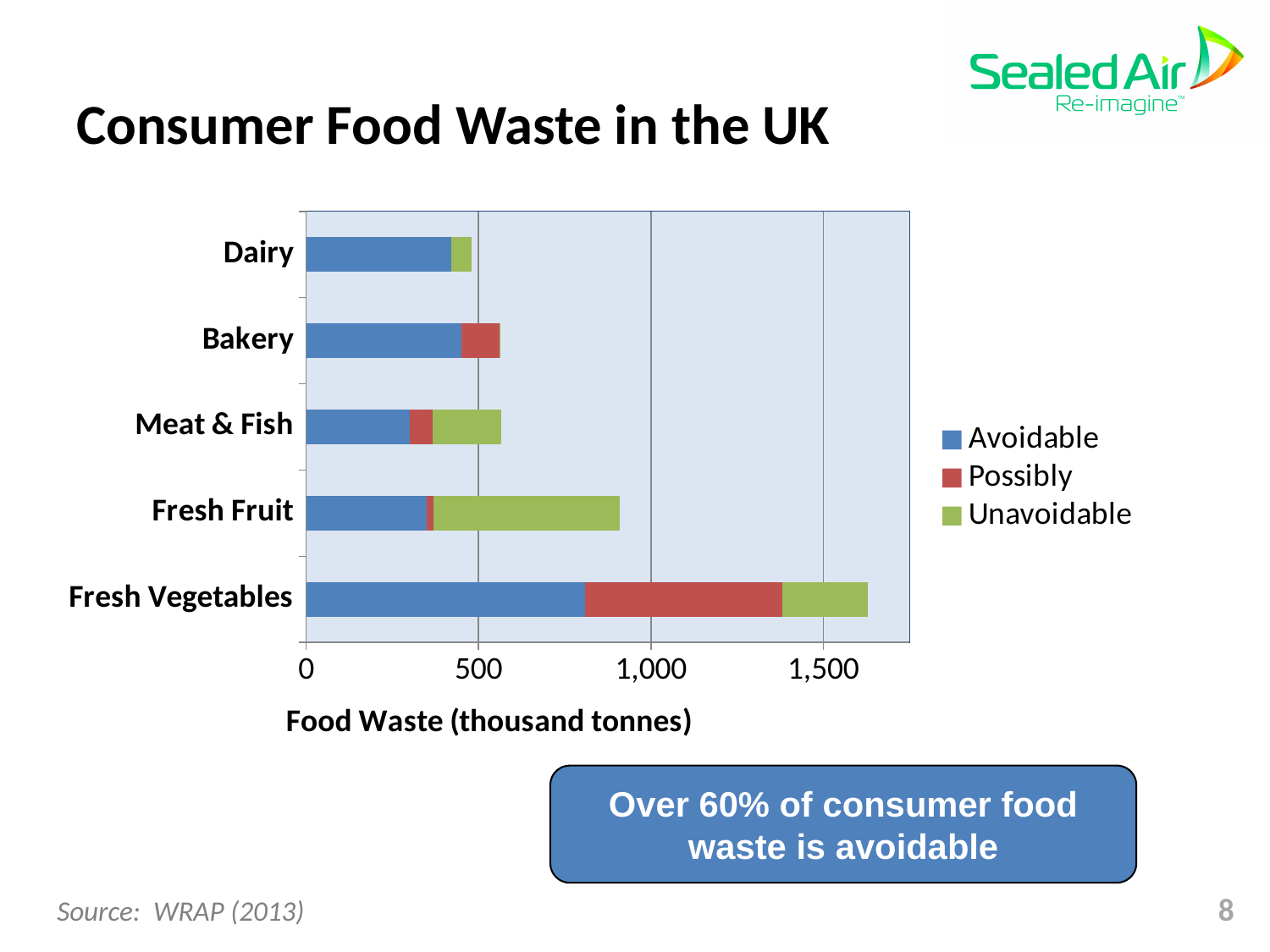
Which food category has the highest total food waste? Fresh Vegetables What is the title of the horizontal axis? Food Waste (thousand tonnes) Is the Avoidable food waste for Fresh Vegetables greater or less than 500 thousand tonnes? greater Is the total food waste for Fresh Vegetables greater or less than 1,500 thousand tonnes? greater How many food categories are shown on the chart? 5 Which has the larger Unavoidable food waste, Fresh Fruit or Dairy? Fresh Fruit Which colour represents the Unavoidable series in the legend? Green What kind of chart is shown on the slide? Stacked bar chart How many series does the legend list? 3 Which food category has the lowest total food waste? Dairy Is the total food waste for Fresh Fruit greater or less than 1,000 thousand tonnes? less Which has the larger total food waste, Fresh Fruit or Meat & Fish? Fresh Fruit